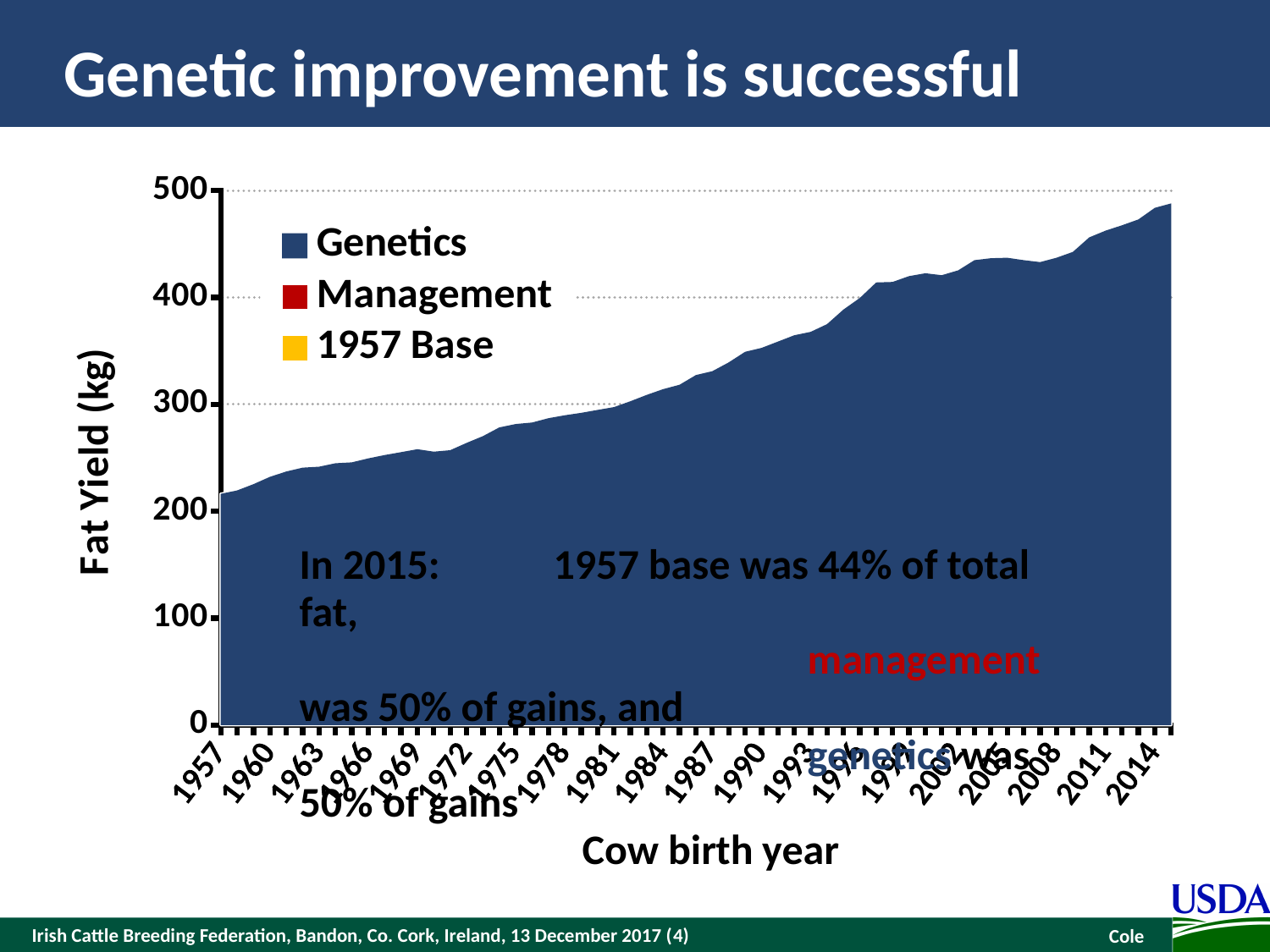
Is the plotted fat yield for 1957 greater or less than 300? less Which cow birth year has the lowest plotted fat yield? 1957 Is the plotted fat yield for 1975 greater or less than 300? less What kind of chart is shown on the slide? Area chart What is the title of the chart's vertical axis? Fat Yield (kg) What is the title of the chart's horizontal axis? Cow birth year How many series does the chart legend list? 3 Is the plotted fat yield for 2014 greater or less than 400? greater Does the plotted fat yield rise or fall as cow birth year increases from 1957 to 2014? Rise Which cow birth year has the larger plotted fat yield, 1957 or 2014? 2014